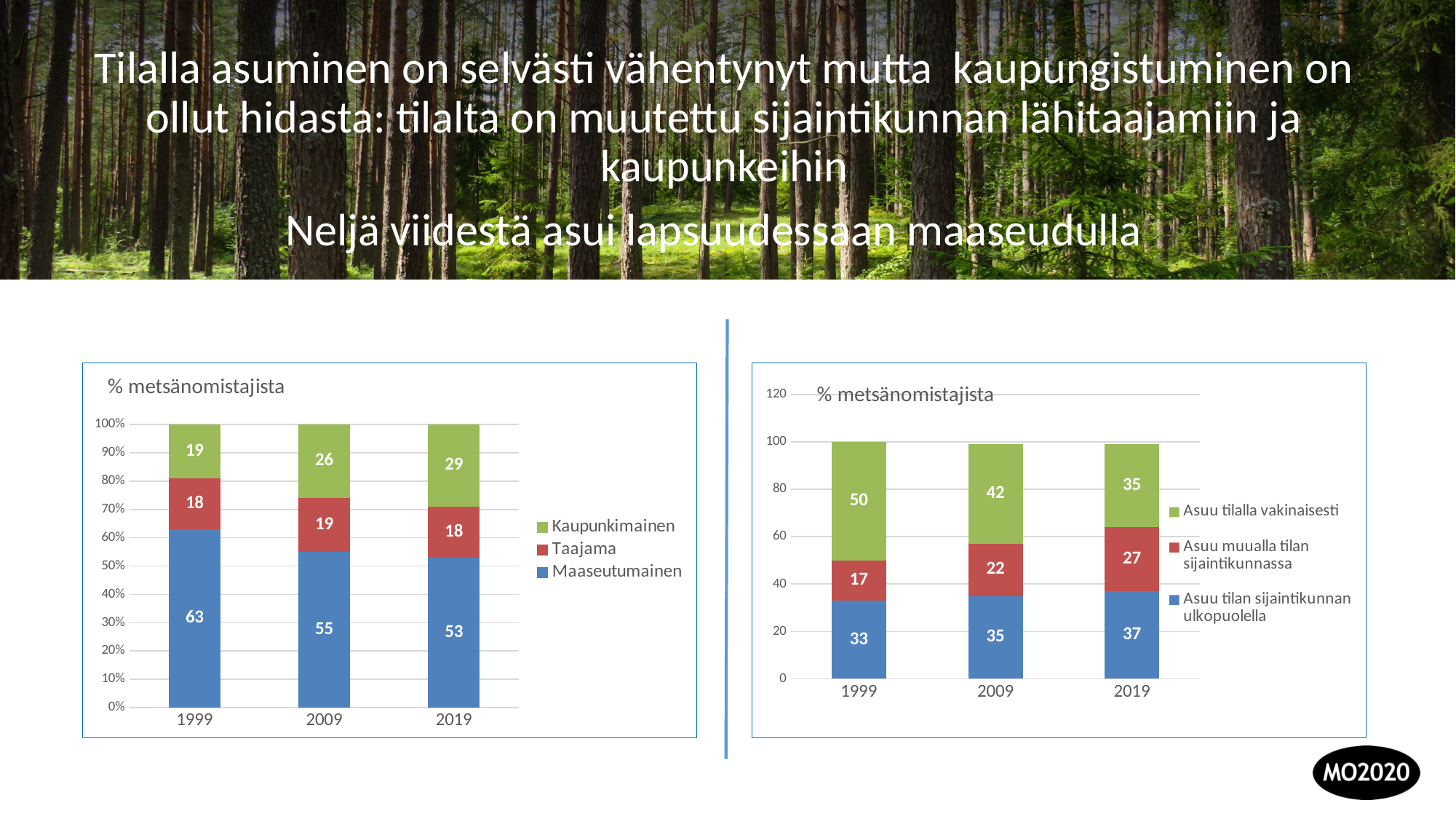
On the right chart, what is the value for Asuu muualla tilan sijaintikunnassa in 2019? 27 On the left chart, what is the value for Maaseutumainen in 1999? 63 On the right chart, what is the value for Asuu tilalla vakinaisesti in 1999? 50 On the left chart, what is the difference between the Kaupunkimainen values for 2019 and 1999? 10 On the right chart, what is the total of the stacked bar for 2009? 99 On the left chart, in which year is the Maaseutumainen value lowest? 2019 On the left chart, does the Kaupunkimainen value rise or fall from 1999 to 2019? rise On the left chart, what is the value for Kaupunkimainen in 2019? 29 On the right chart, which is larger in 2019: Asuu tilalla vakinaisesti or Asuu tilan sijaintikunnan ulkopuolella? Asuu tilan sijaintikunnan ulkopuolella How many series does the legend of the left chart list? 3 What type of chart is the right chart? stacked bar chart How many years are shown on the x axis of the right chart? 3